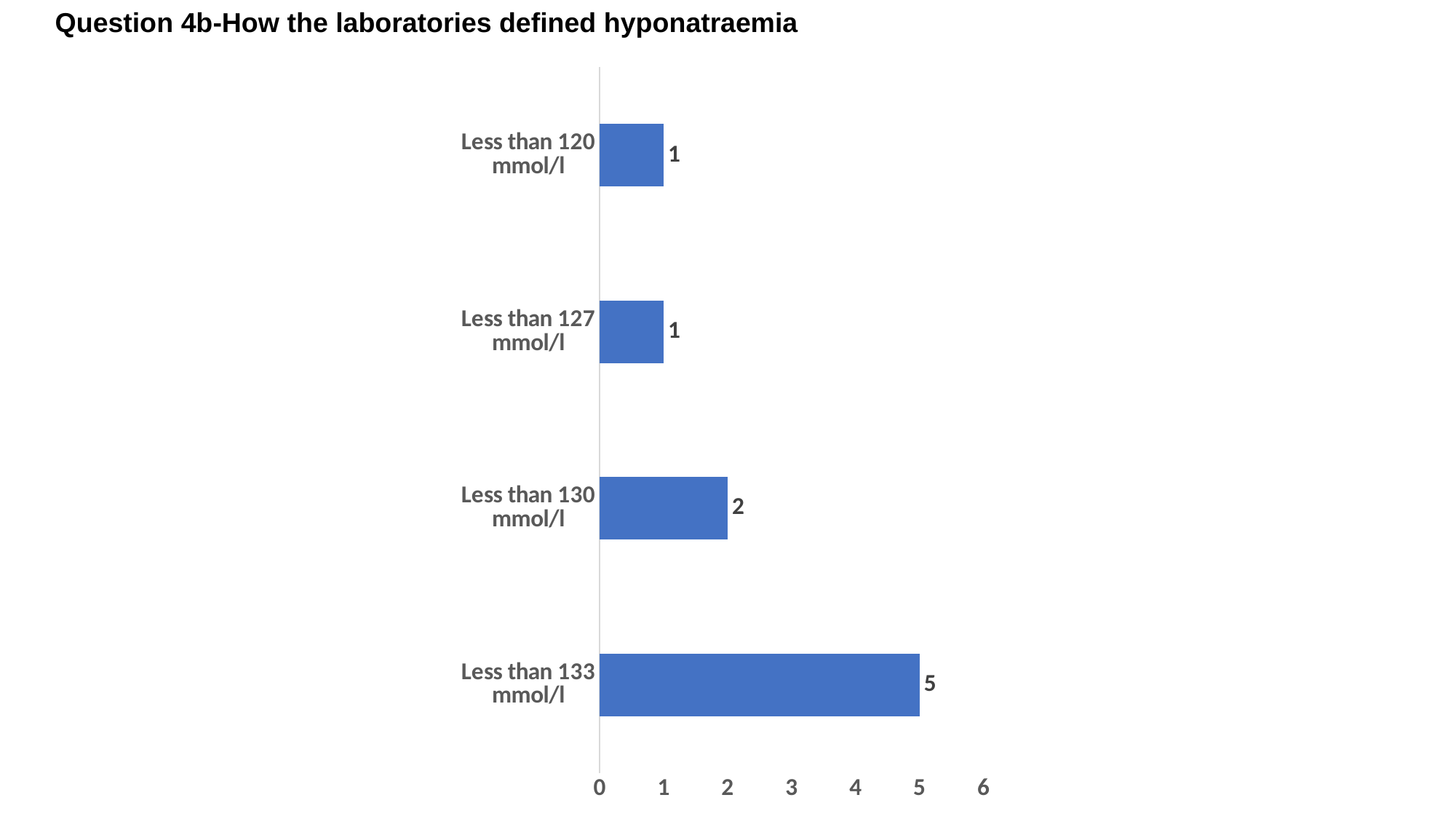
Which is larger, the value for 'Less than 133 mmol/l' or 'Less than 120 mmol/l'? Less than 133 mmol/l What is the value for 'Less than 130 mmol/l'? 2 What is the difference between the values for 'Less than 130 mmol/l' and 'Less than 127 mmol/l'? 1 What is the title of the chart? Question 4b-How the laboratories defined hyponatraemia Which category has the highest value? Less than 133 mmol/l What is the value for 'Less than 127 mmol/l'? 1 How many categories are shown in the chart? 4 What is the value for 'Less than 133 mmol/l'? 5 Is the value for 'Less than 133 mmol/l' greater or less than 4? greater What is the value for 'Less than 120 mmol/l'? 1 What kind of chart is shown on the slide? Bar chart What is the difference between the values for 'Less than 133 mmol/l' and 'Less than 130 mmol/l'? 3